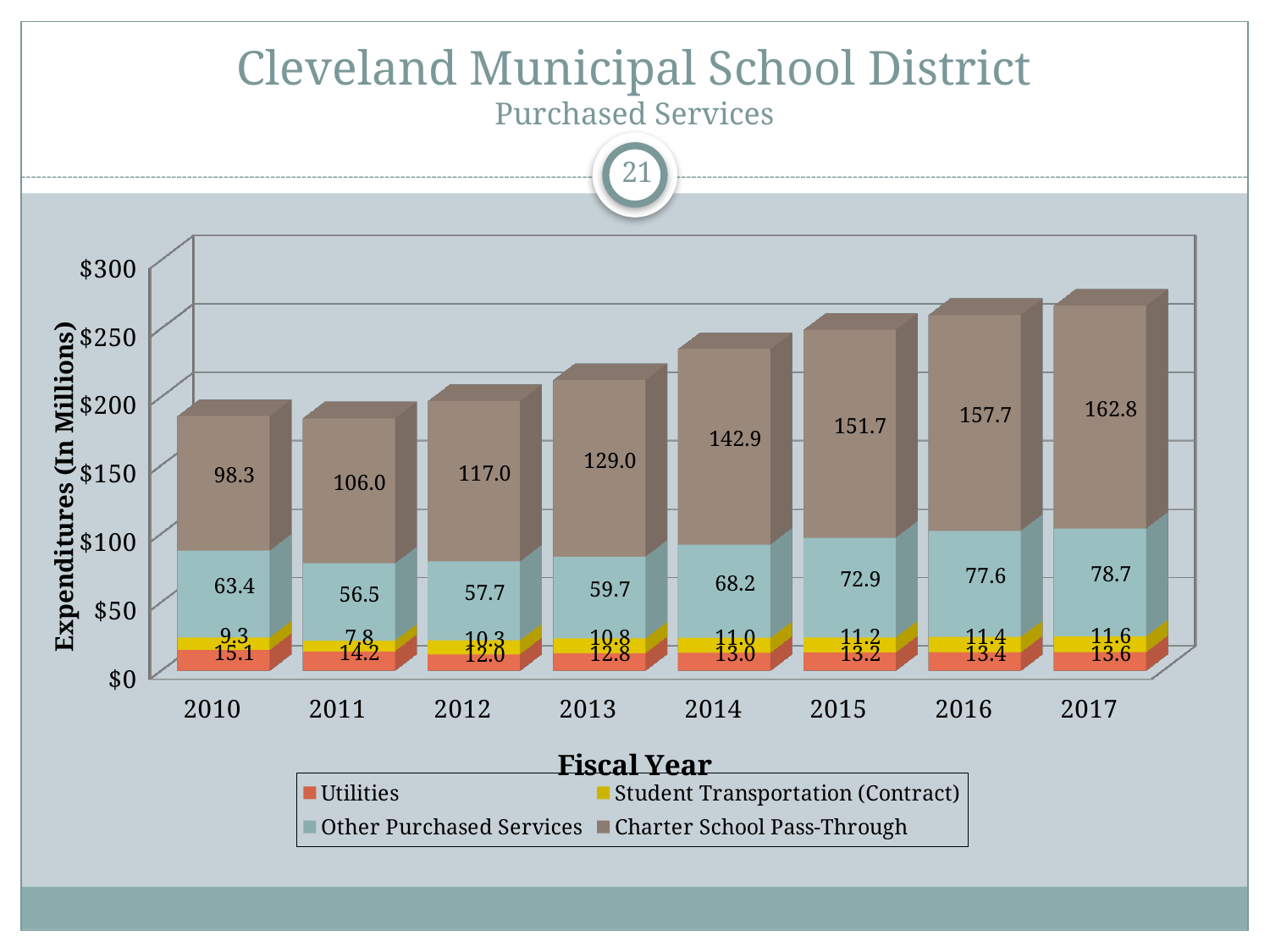
How many series does the legend list? 4 What is the Other Purchased Services value for 2011? 56.5 What type of chart is shown on the slide? Stacked bar chart Which is larger, the Other Purchased Services value for 2010 or for 2012? 2010 In which fiscal year is the Charter School Pass-Through value highest? 2017 In which fiscal year is the Student Transportation (Contract) value lowest? 2011 What is the difference between the Charter School Pass-Through values for 2017 and 2010? 64.5 What is the Utilities value for 2010? 15.1 What is the Charter School Pass-Through value for 2014? 142.9 What is the total of the stacked bar for 2017? 266.7 How many fiscal years are shown on the x axis? 8 What is the Student Transportation (Contract) value for 2016? 11.4